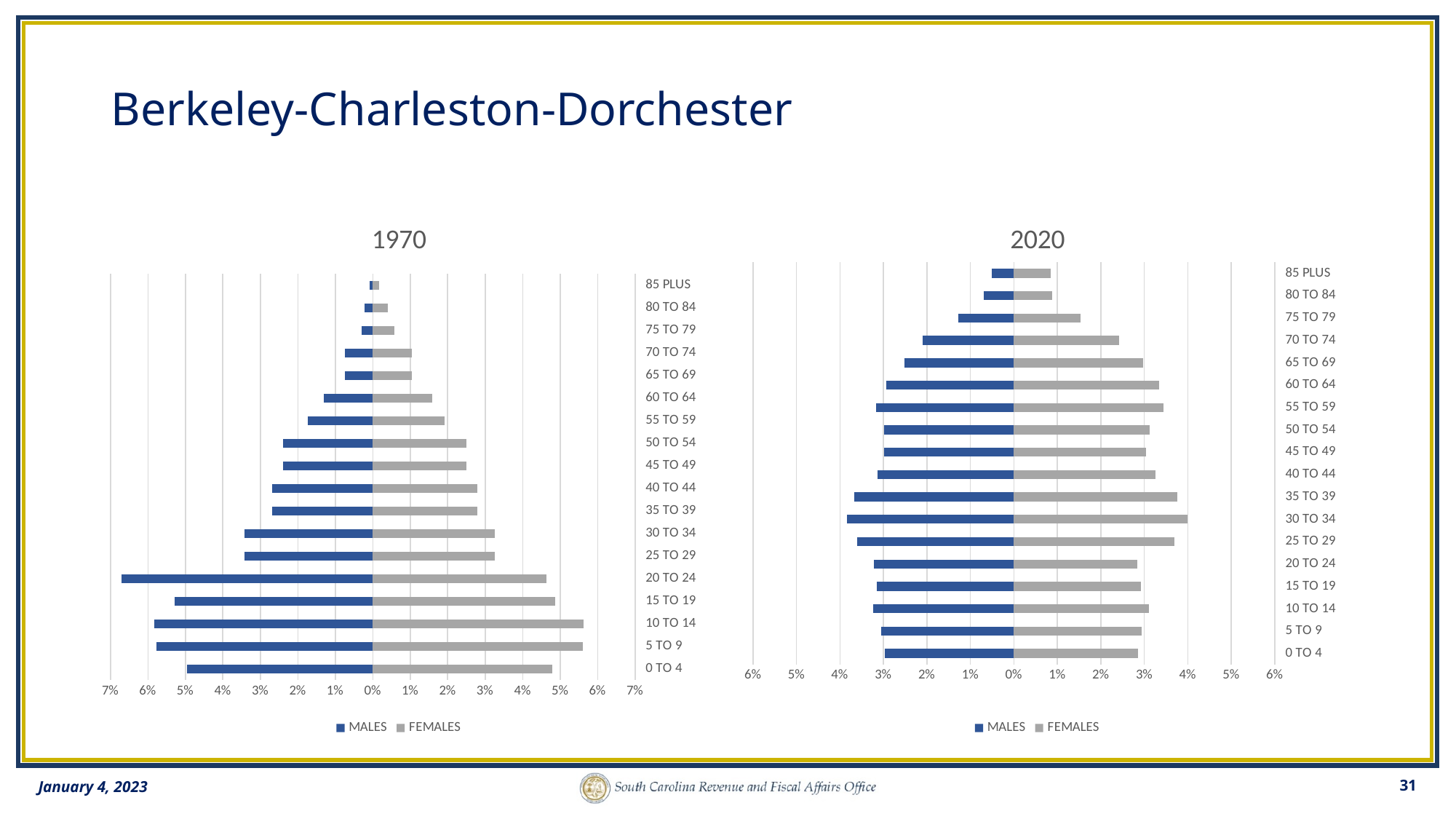
How many age groups are shown on the 2020 chart? 18 What kind of chart is the 1970 chart? bar chart How many series does the legend of the 1970 chart list? 2 On the 2020 chart, is the MALES value for 75 TO 79 greater or less than 1%? greater On the 1970 chart, which is larger for the 20 TO 24 age group, MALES or FEMALES? MALES What colour are the MALES bars on the 2020 chart? blue On the 2020 chart, which is larger for the 85 PLUS age group, MALES or FEMALES? FEMALES On the 1970 chart, is the MALES value for 20 TO 24 greater or less than 6%? greater On the 2020 chart, is the MALES value for 30 TO 34 greater or less than 3%? greater On the 1970 chart, which age group has the longest MALES bar? 20 TO 24 On the 1970 chart, which age group has the shortest MALES bar? 85 PLUS